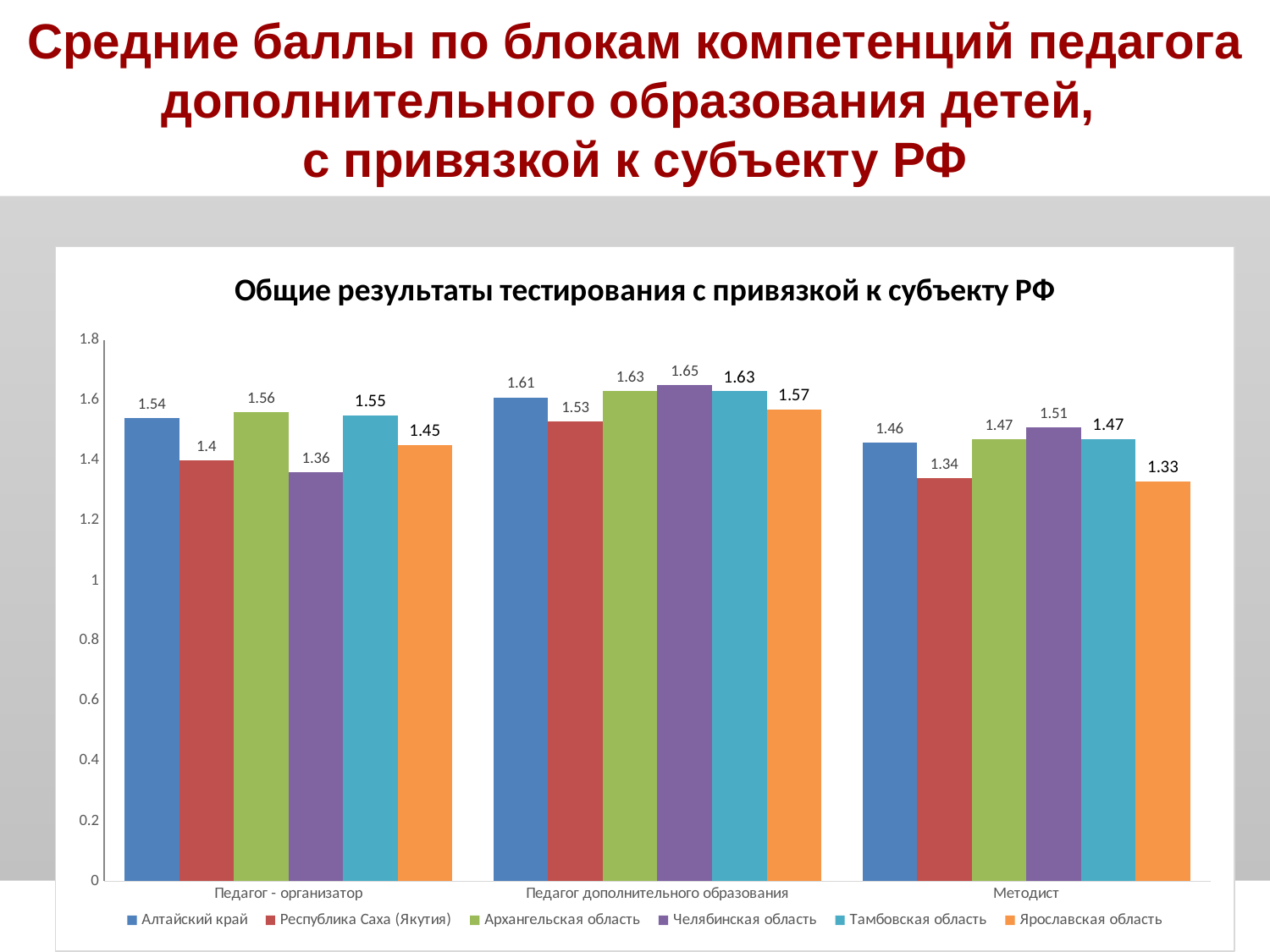
Which is larger for Алтайский край: the Педагог дополнительного образования value or the Методист value? Педагог дополнительного образования Is the value for Тамбовская область in the Методист category greater or less than 1.4? greater What is the difference between the Архангельская область value and the Республика Саха (Якутия) value in the Педагог - организатор category? 0.16 Which region has the lowest value in the Педагог - организатор category? Челябинская область How many categories are shown on the x axis? 3 Which region has the highest value in the Педагог дополнительного образования category? Челябинская область What type of chart is shown on the slide? Bar chart What is the value for Челябинская область in the Педагог дополнительного образования category? 1.65 How many series does the legend list? 6 What is the value for Республика Саха (Якутия) in the Методист category? 1.34 What is the value for Ярославская область in the Педагог - организатор category? 1.45 Which region has the lowest value in the Методист category? Ярославская область